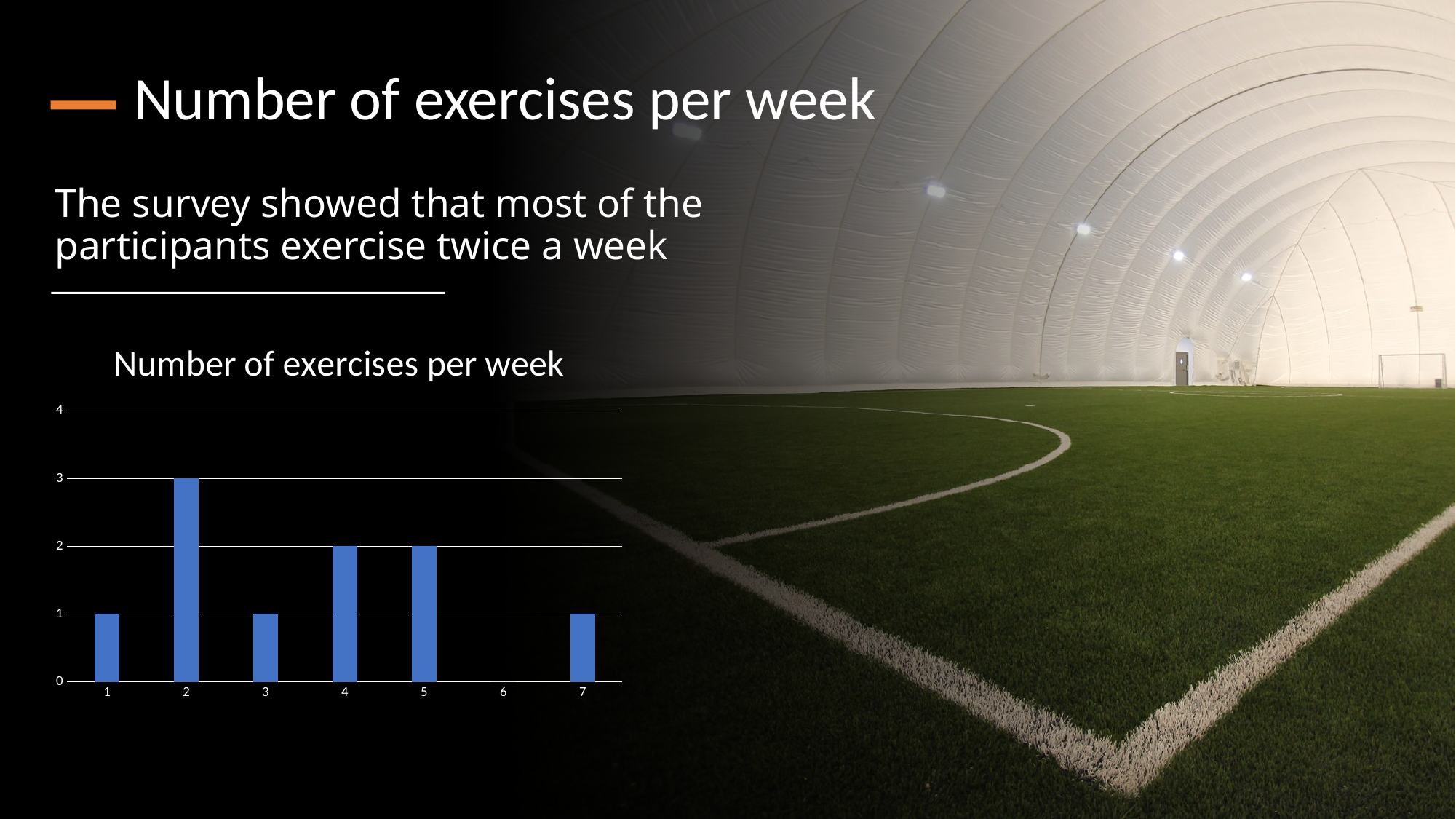
What is the value for category 2? 3 What is the value for category 4? 2 How many categories are shown on the x axis of the chart? 7 What is the highest value shown on the vertical axis of the chart? 4 Is the value for category 2 greater or less than 2? greater Which is larger, the value for category 4 or the value for category 3? category 4 What type of chart is shown on the slide? bar chart What is the title of the chart? Number of exercises per week Which category has no bar (a value of 0) in the chart? 6 What is the difference between the values for category 2 and category 1? 2 Which category has the highest bar in the chart? 2 What is the value for category 7? 1